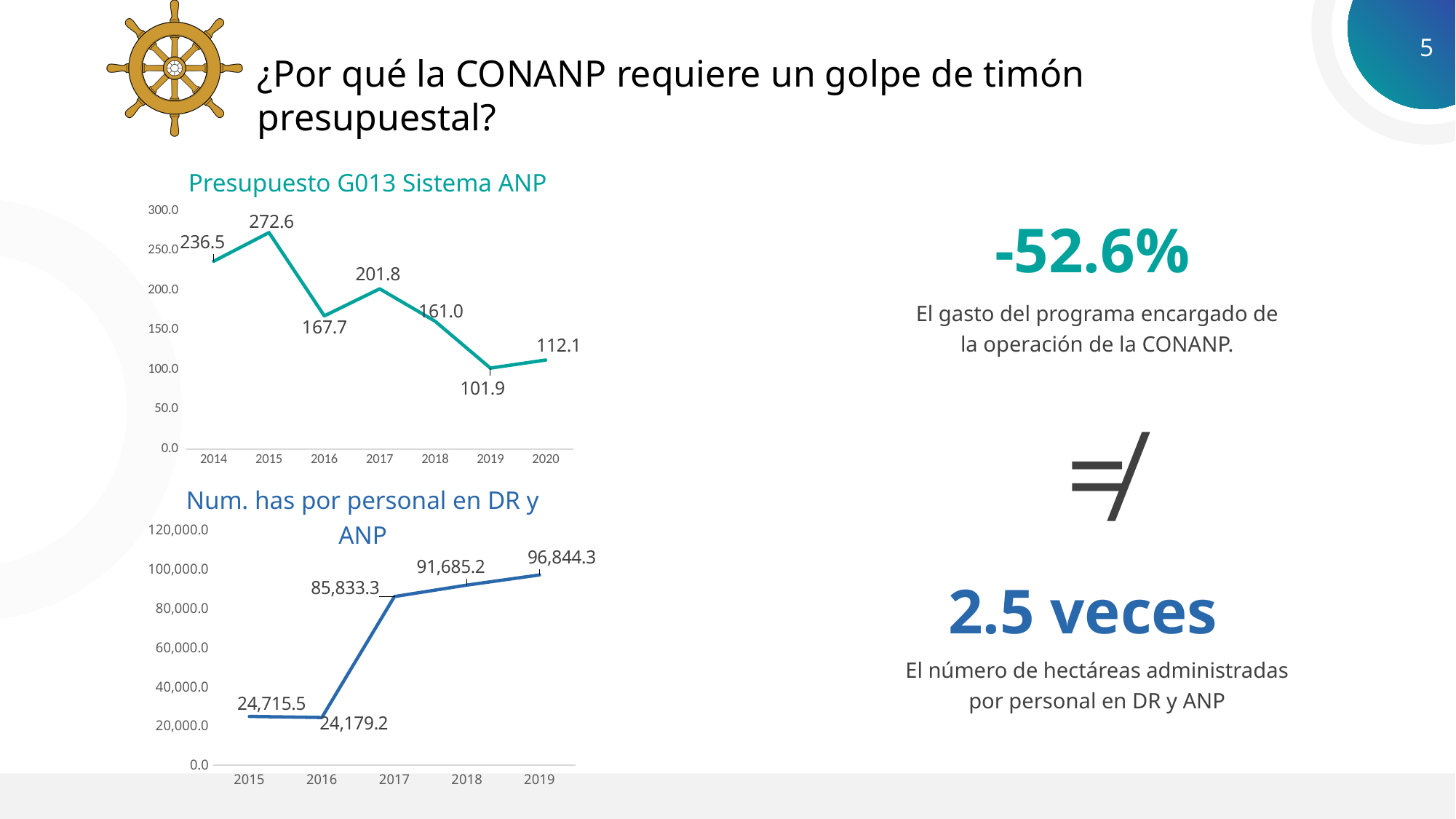
In the 'Presupuesto G013 Sistema ANP' chart, what is the difference between the 2014 and 2020 values? 124.4 In the 'Num. has por personal en DR y ANP' chart, which year has the highest value? 2019 In the 'Num. has por personal en DR y ANP' chart, how many years are plotted? 5 In the 'Presupuesto G013 Sistema ANP' chart, which year has the lowest value? 2019 In the 'Presupuesto G013 Sistema ANP' chart, do the values generally rise or fall from 2014 to 2020? fall In the 'Num. has por personal en DR y ANP' chart, which is larger, the value for 2015 or 2016? 2015 In the 'Presupuesto G013 Sistema ANP' chart, which year has the highest value? 2015 In the 'Num. has por personal en DR y ANP' chart, what is the difference between the 2019 and 2018 values? 5,159.1 In the 'Num. has por personal en DR y ANP' chart, what is the value for 2017? 85,833.3 In the 'Presupuesto G013 Sistema ANP' chart, how many years are plotted? 7 What type of chart is 'Presupuesto G013 Sistema ANP'? line chart In the 'Presupuesto G013 Sistema ANP' chart, what is the value for 2015? 272.6